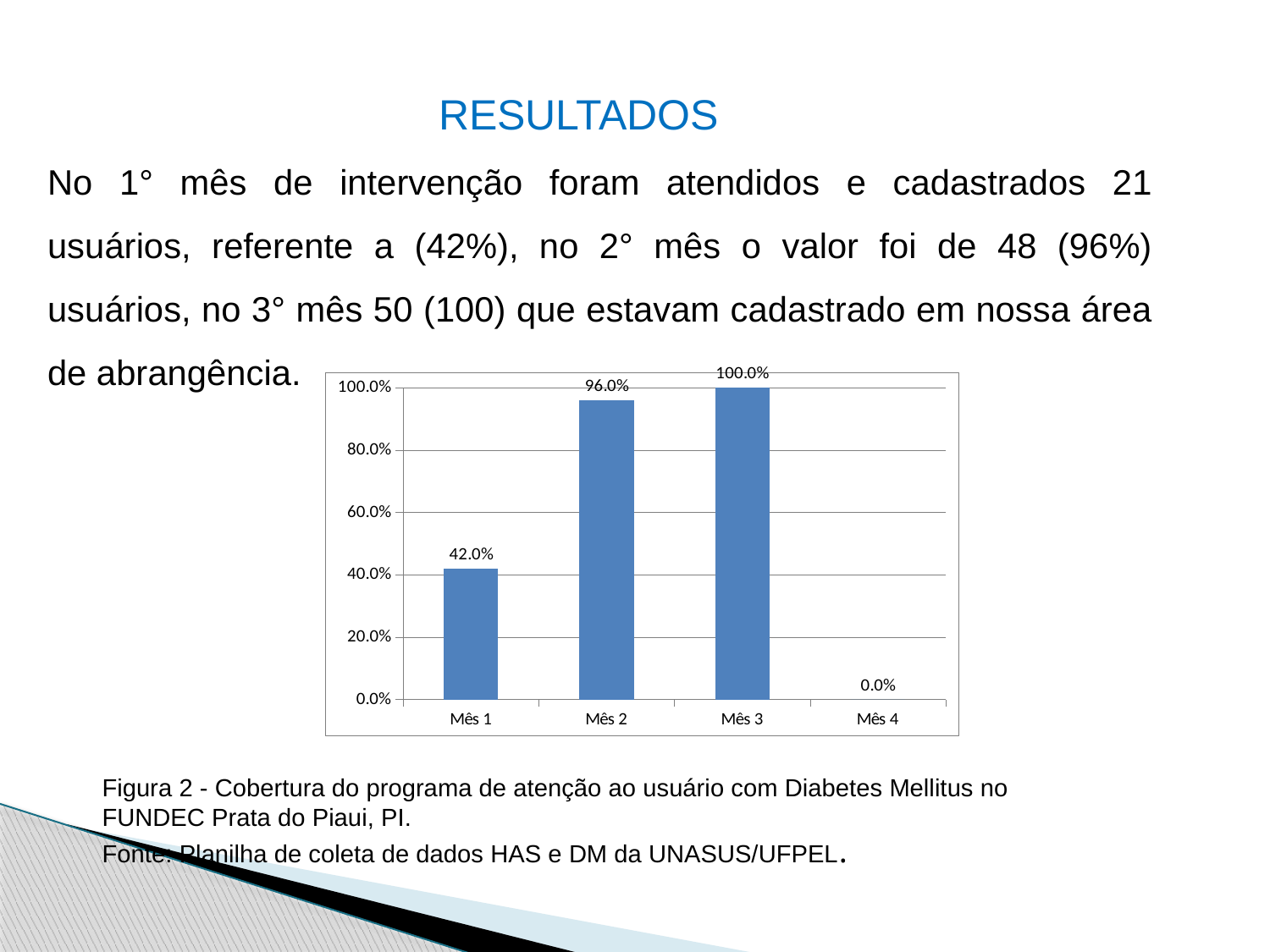
What is the value for Mês 2? 96.0% What is the difference between the values for Mês 2 and Mês 1? 54.0% What kind of chart is shown on the slide? bar chart Which is larger, the value for Mês 1 or the value for Mês 2? Mês 2 What is the value for Mês 1? 42.0% Is the value for Mês 1 greater or less than 60.0%? less Do the values rise or fall from Mês 1 to Mês 3? rise Which category has the highest value? Mês 3 How many categories are shown on the x axis? 4 What is the value for Mês 4? 0.0% Which category has the lowest value? Mês 4 What is the value for Mês 3? 100.0%